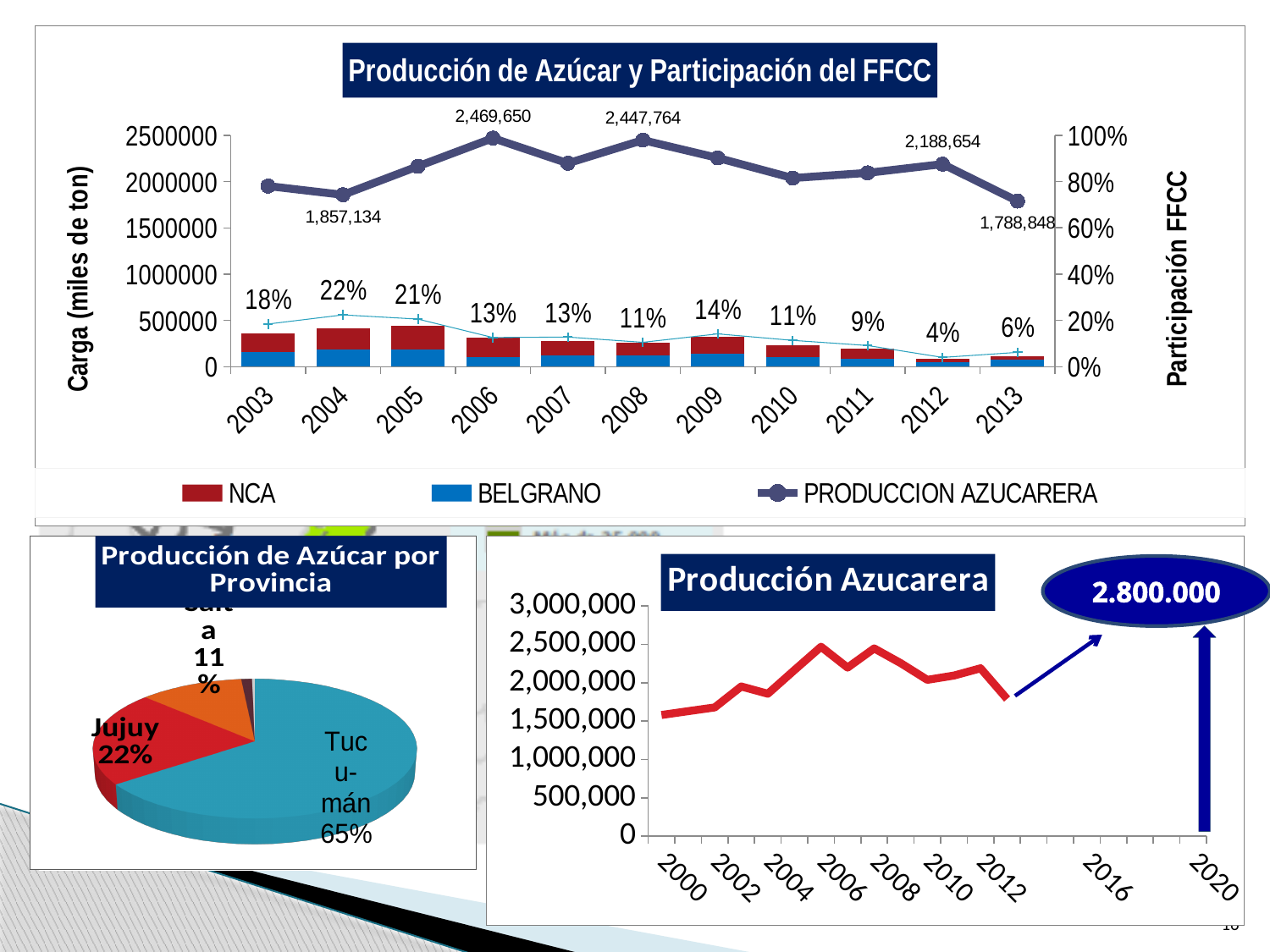
In the pie chart 'Producción de Azúcar por Provincia', which province has the largest share? Tucumán In the chart 'Producción de Azúcar y Participación del FFCC', what is the difference between the sugar production in 2006 and in 2013? 680,802 In the chart 'Producción de Azúcar y Participación del FFCC', how many years are shown on the x axis? 11 In the chart 'Producción de Azúcar y Participación del FFCC', how many series does the legend list? 3 In the chart 'Producción de Azúcar y Participación del FFCC', what was the sugar production in 2013? 1,788,848 In the chart 'Producción de Azúcar y Participación del FFCC', what was the sugar production (PRODUCCION AZUCARERA) in 2006? 2,469,650 In the chart 'Producción de Azúcar y Participación del FFCC', which year had the highest FFCC participation percentage? 2004 What kind of chart is the bottom-right chart titled 'Producción Azucarera'? line chart In the pie chart 'Producción de Azúcar por Provincia', what share does Tucumán have? 65% In the chart 'Producción de Azúcar y Participación del FFCC', what was the FFCC participation percentage in 2009? 14% In the chart 'Producción de Azúcar y Participación del FFCC', which year had the lowest FFCC participation percentage? 2012 In the chart 'Producción de Azúcar y Participación del FFCC', is the sugar production in 2005 greater or less than 2000000? greater